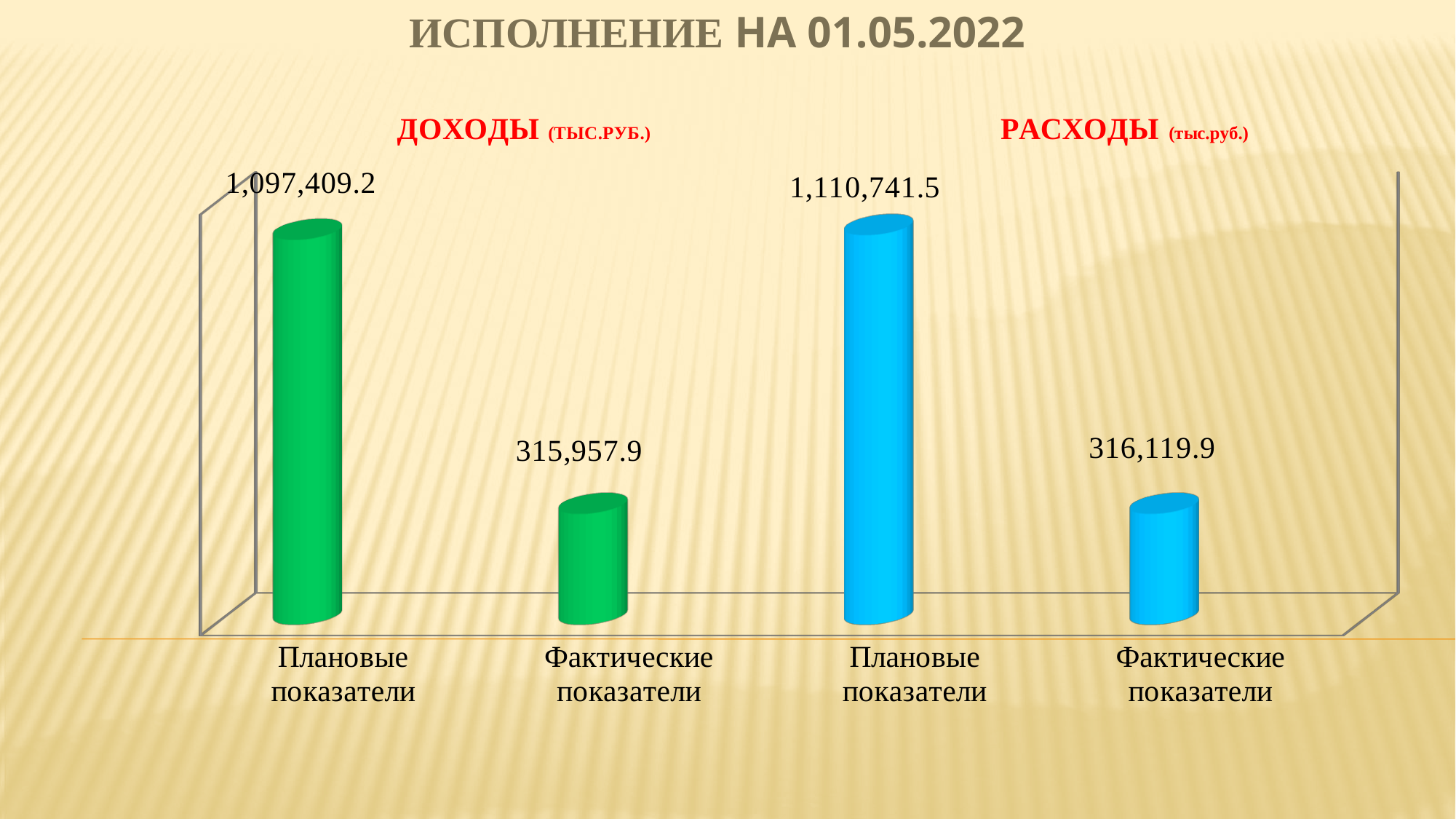
What is the value of the actual indicators (Фактические показатели) bar under РАСХОДЫ? 316,119.9 How many bars are plotted on the chart? 4 What is the value of the planned indicators (Плановые показатели) bar under РАСХОДЫ? 1,110,741.5 What is the difference between the planned and actual indicators under ДОХОДЫ? 781,451.3 Which bar on the chart has the highest value? Плановые показатели under РАСХОДЫ (1,110,741.5) Which is larger: the planned indicators under ДОХОДЫ or the planned indicators under РАСХОДЫ? Planned indicators under РАСХОДЫ (1,110,741.5) What is the difference between the planned and actual indicators under РАСХОДЫ? 794,621.6 What kind of chart is shown on the slide? Bar chart Which bar on the chart has the lowest value? Фактические показатели under ДОХОДЫ (315,957.9) What is the value of the planned indicators (Плановые показатели) bar under ДОХОДЫ? 1,097,409.2 What is the value of the actual indicators (Фактические показатели) bar under ДОХОДЫ? 315,957.9 What colour are the bars under РАСХОДЫ? Blue